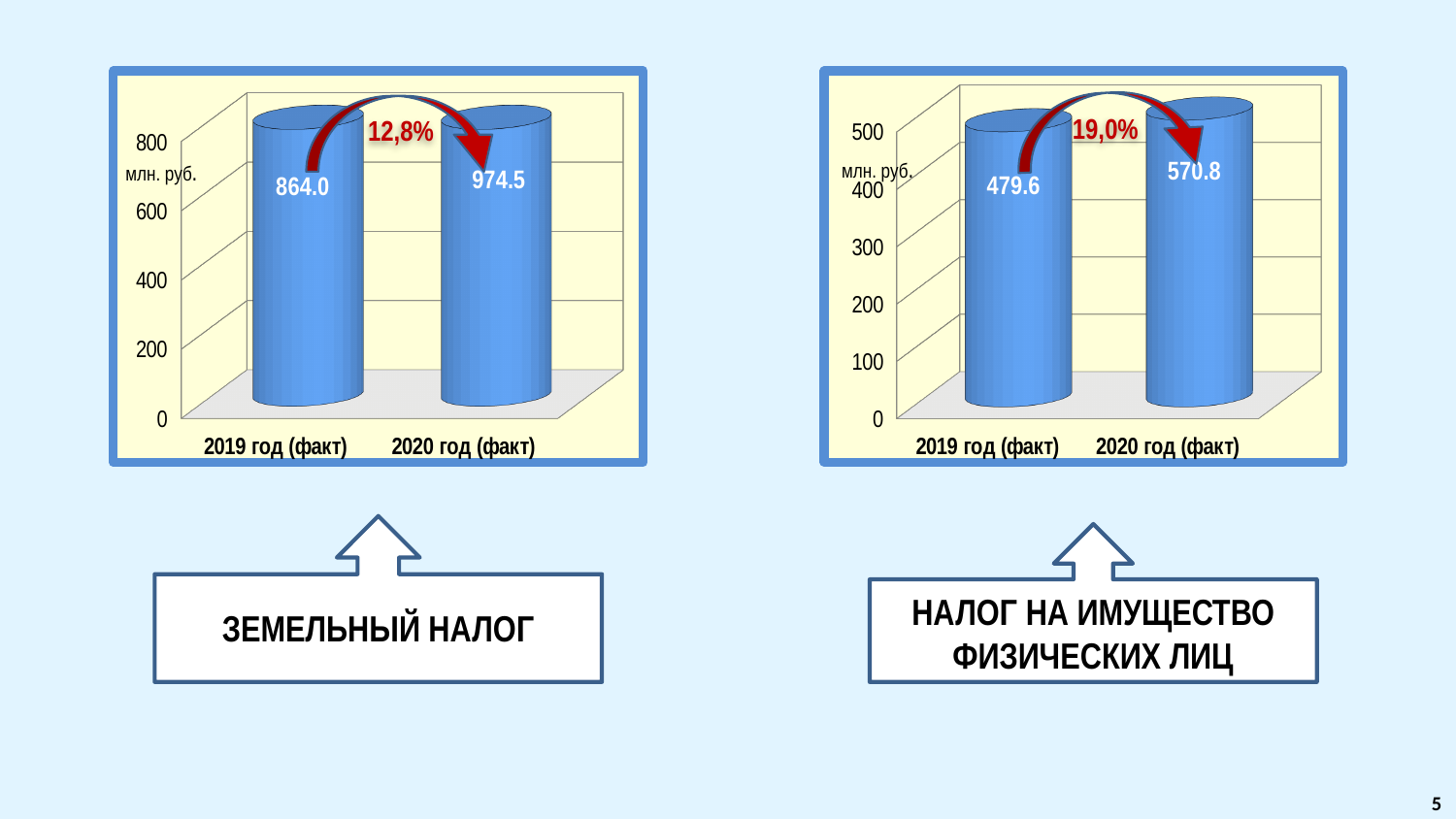
In the right chart (НАЛОГ НА ИМУЩЕСТВО ФИЗИЧЕСКИХ ЛИЦ), which year has the lower value? 2019 год (факт) In the right chart (НАЛОГ НА ИМУЩЕСТВО ФИЗИЧЕСКИХ ЛИЦ), what is the value for 2020 год (факт)? 570.8 What percentage change is shown by the arrow in the left chart (ЗЕМЕЛЬНЫЙ НАЛОГ)? 12,8% In the left chart (ЗЕМЕЛЬНЫЙ НАЛОГ), do the values rise or fall from 2019 to 2020? rise In the left chart (ЗЕМЕЛЬНЫЙ НАЛОГ), what is the value for 2020 год (факт)? 974.5 In the left chart (ЗЕМЕЛЬНЫЙ НАЛОГ), what is the value for 2019 год (факт)? 864.0 In the left chart (ЗЕМЕЛЬНЫЙ НАЛОГ), what is the difference between the 2020 and 2019 values? 110.5 In the right chart (НАЛОГ НА ИМУЩЕСТВО ФИЗИЧЕСКИХ ЛИЦ), what is the difference between the 2020 and 2019 values? 91.2 In the right chart (НАЛОГ НА ИМУЩЕСТВО ФИЗИЧЕСКИХ ЛИЦ), what is the value for 2019 год (факт)? 479.6 What type of chart is the left chart (ЗЕМЕЛЬНЫЙ НАЛОГ)? bar chart What percentage change is shown by the arrow in the right chart (НАЛОГ НА ИМУЩЕСТВО ФИЗИЧЕСКИХ ЛИЦ)? 19,0% In the left chart (ЗЕМЕЛЬНЫЙ НАЛОГ), which year has the higher value? 2020 год (факт)